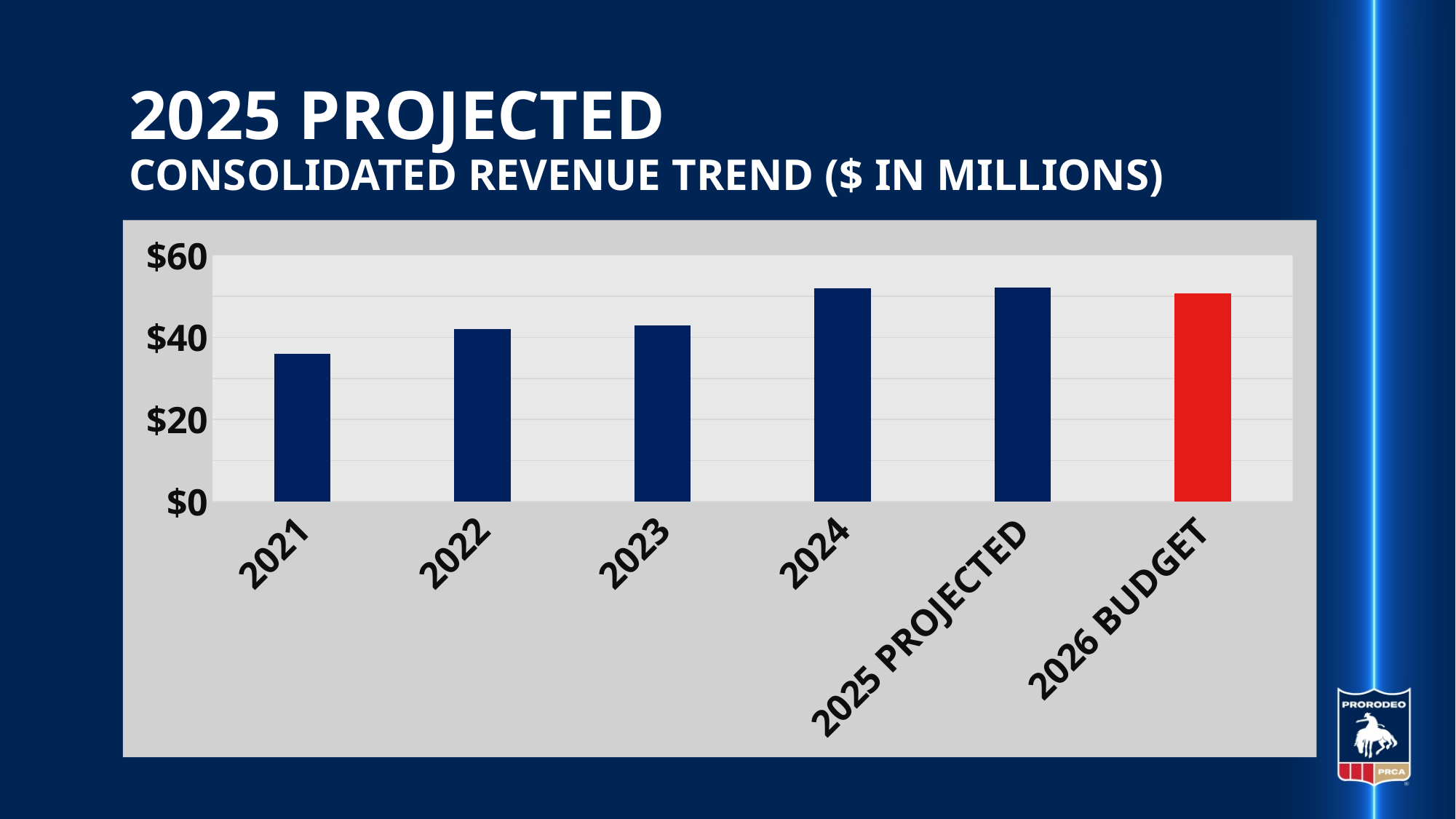
Which category's bar is shown in red rather than dark blue? 2026 BUDGET Is the value for 2024 greater or less than $40? greater Which category has the lowest value in the chart? 2021 Is the value for 2025 PROJECTED greater or less than $40? greater How many categories are plotted on the x axis of the chart? 6 Do the values rise or fall from 2021 to 2024? rise Which is larger, the value for 2026 BUDGET or the value for 2021? 2026 BUDGET Is the value for 2026 BUDGET greater or less than $60? less What unit does the chart's subtitle say the revenue values are in? $ in millions Which is larger, the value for 2021 or the value for 2024? 2024 What kind of chart is shown on the slide? bar chart